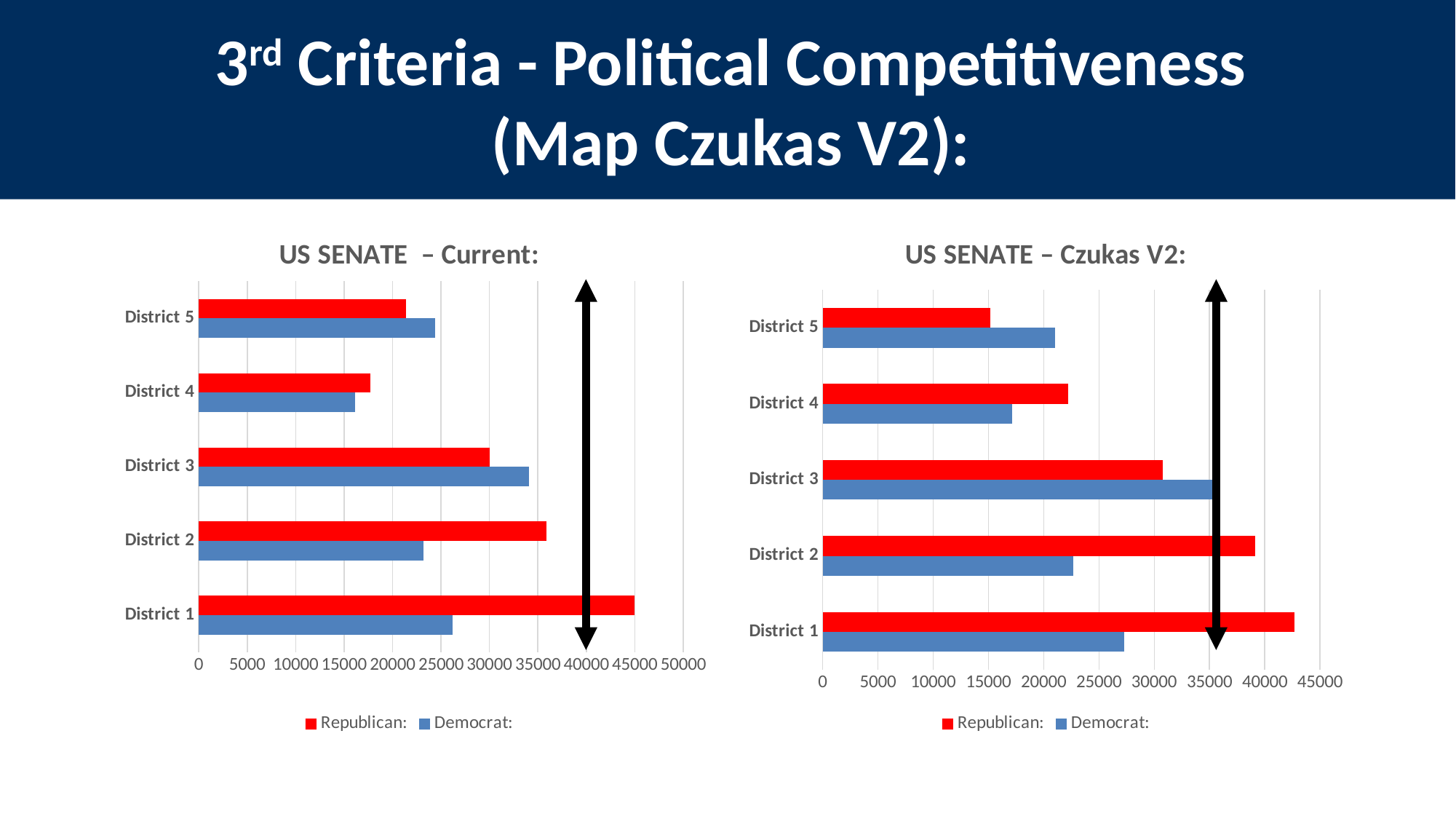
In the 'US SENATE – Czukas V2:' chart, which district has the lowest Republican value? District 5 What are the two legend entries on the 'US SENATE – Current:' chart? Republican and Democrat In the 'US SENATE – Current:' chart, for District 3, which is larger: Republican or Democrat? Democrat In the 'US SENATE – Czukas V2:' chart, is the Republican value for District 5 greater or less than 20000? less In the 'US SENATE – Current:' chart, is the Republican value for District 1 greater or less than 40000? greater In the 'US SENATE – Current:' chart, which district has the lowest Republican value? District 4 In the 'US SENATE – Czukas V2:' chart, for District 2, which is larger: Republican or Democrat? Republican In the 'US SENATE – Czukas V2:' chart, which district has the highest Democrat value? District 3 How many districts are shown on the 'US SENATE – Current:' chart? 5 What type of chart is the 'US SENATE – Current:' chart? bar chart In the 'US SENATE – Current:' chart, which district has the highest Republican value? District 1 How many series does the legend of the 'US SENATE – Czukas V2:' chart list? 2